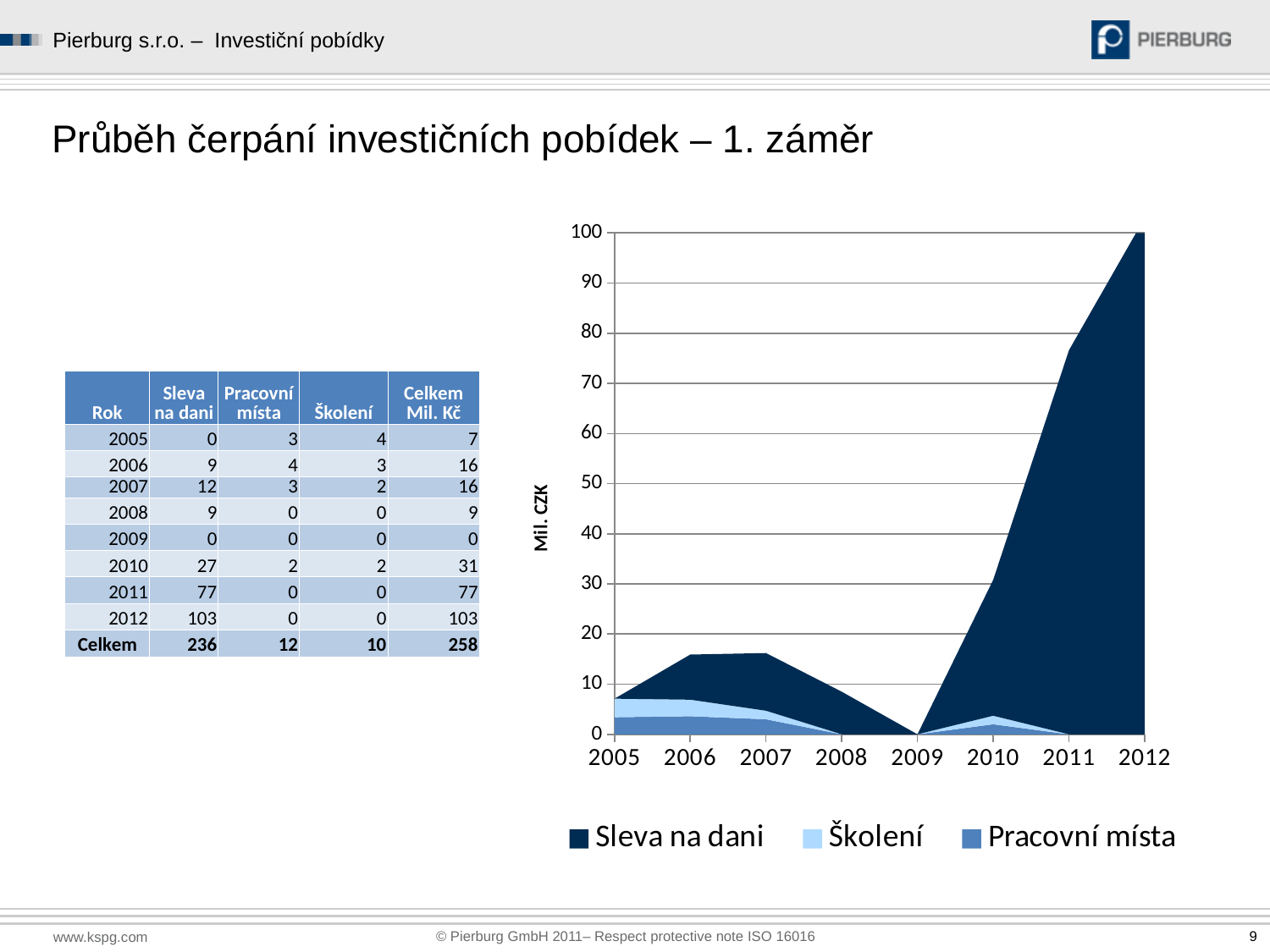
How many series does the chart's legend list? 3 What is the label on the chart's vertical axis? Mil. CZK Is the stacked total for 2010 in the chart greater or less than 40? less In which year does the stacked total in the chart reach its highest value? 2012 In which year is the stacked total in the chart at its lowest? 2009 What kind of chart is shown on the slide? Area chart Do the stacked totals in the chart rise or fall from 2009 to 2012? rise What is the stacked total shown in the chart for 2009? 0 Which year has the larger stacked total in the chart, 2006 or 2008? 2006 How many years are shown along the x axis of the chart? 8 Is the stacked total for 2007 in the chart greater or less than 20? less Is the stacked total for 2011 in the chart greater or less than 70? greater